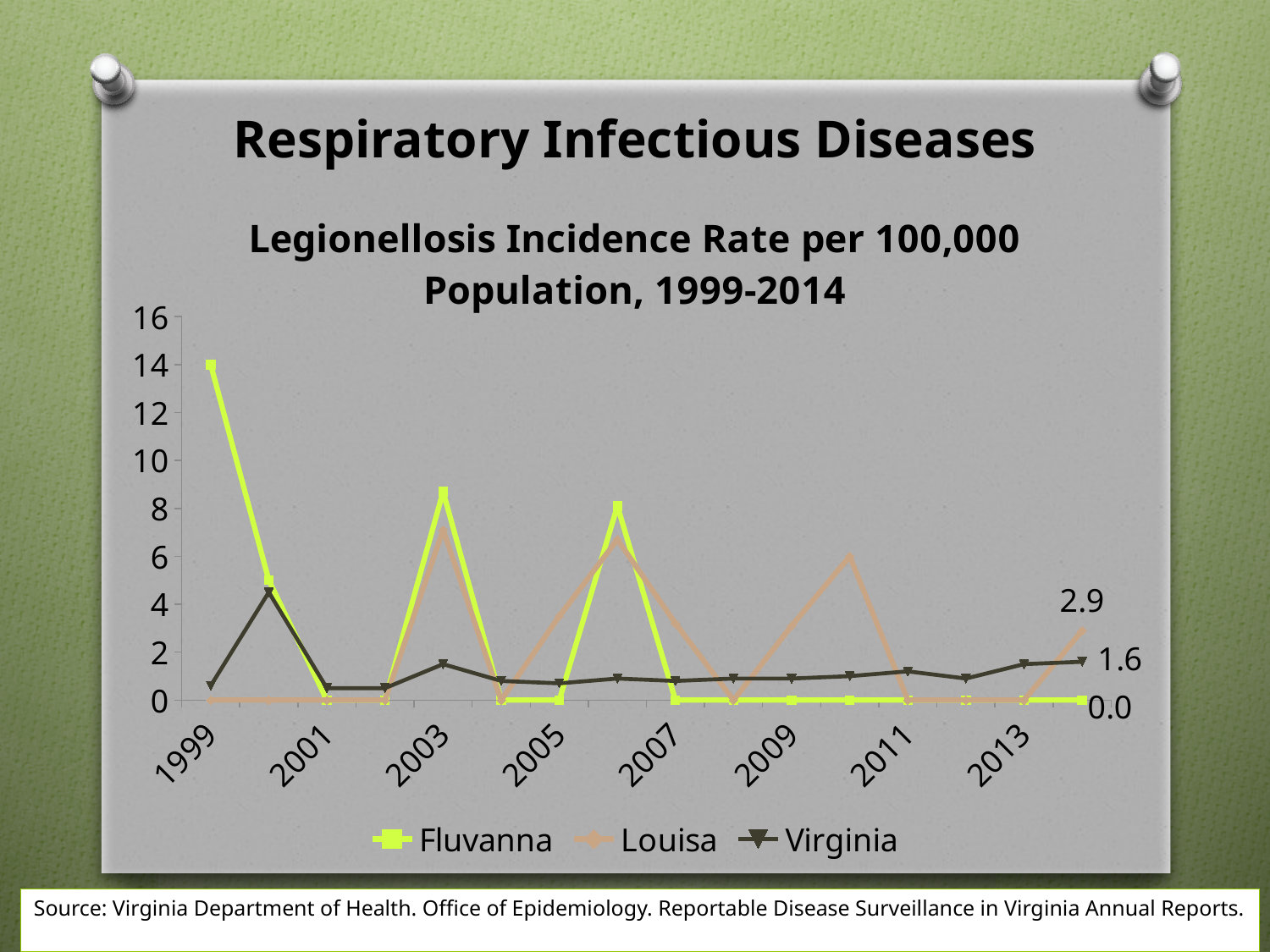
Which series has the highest labelled value in 2014? Louisa In which year does the Fluvanna series reach its highest value? 1999 Which series has the lowest labelled value in 2014? Fluvanna What is the title of the chart? Legionellosis Incidence Rate per 100,000 Population, 1999-2014 What is the Louisa value in 2014, as labelled on the chart? 2.9 What is the difference between the Louisa and Virginia values in 2014? 1.3 What is the Virginia value in 2014, as labelled on the chart? 1.6 What is the Fluvanna value in 2014, as labelled on the chart? 0.0 Which series are listed in the chart legend? Fluvanna, Louisa, Virginia What kind of chart is shown on the slide? line chart Is the Fluvanna value in 1999 greater or less than 12? greater How many series does the chart legend list? 3